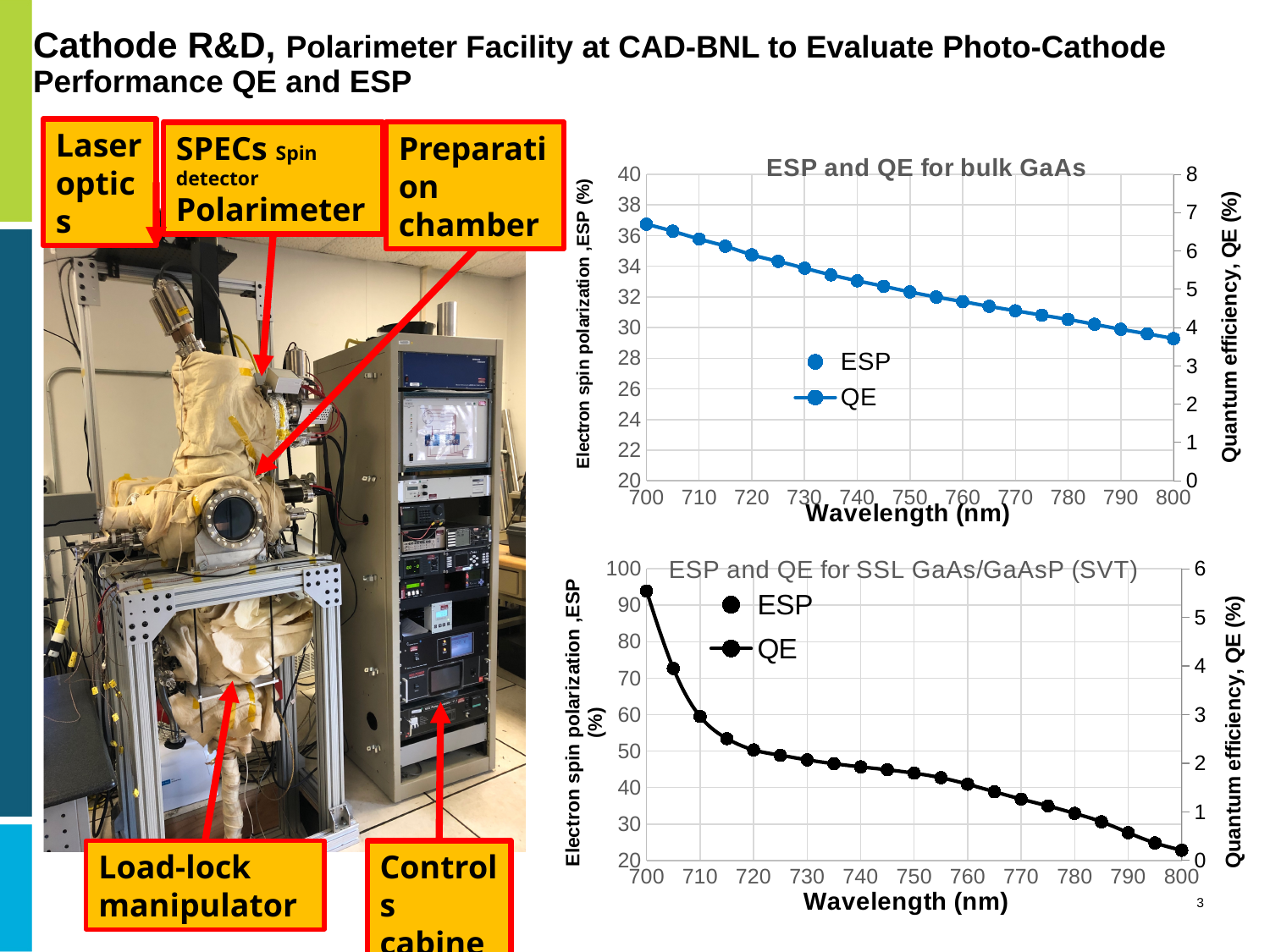
In the bottom chart (ESP and QE for SSL GaAs/GaAsP (SVT)), do the plotted values rise or fall as wavelength increases? fall How many series does the legend of the top chart (ESP and QE for bulk GaAs) list? 2 What are the two legend entries in the bottom chart (ESP and QE for SSL GaAs/GaAsP (SVT))? ESP and QE In the bottom chart (ESP and QE for SSL GaAs/GaAsP (SVT)), which has the larger plotted value, 700 nm or 710 nm? 700 nm In the top chart (ESP and QE for bulk GaAs), do the plotted values rise or fall as wavelength increases from 700 to 800 nm? fall In the top chart (ESP and QE for bulk GaAs), at which wavelength is the plotted value highest? 700 nm What kind of chart is the top chart titled "ESP and QE for bulk GaAs"? line chart What is the label of the x axis of the bottom chart (ESP and QE for SSL GaAs/GaAsP (SVT))? Wavelength (nm)